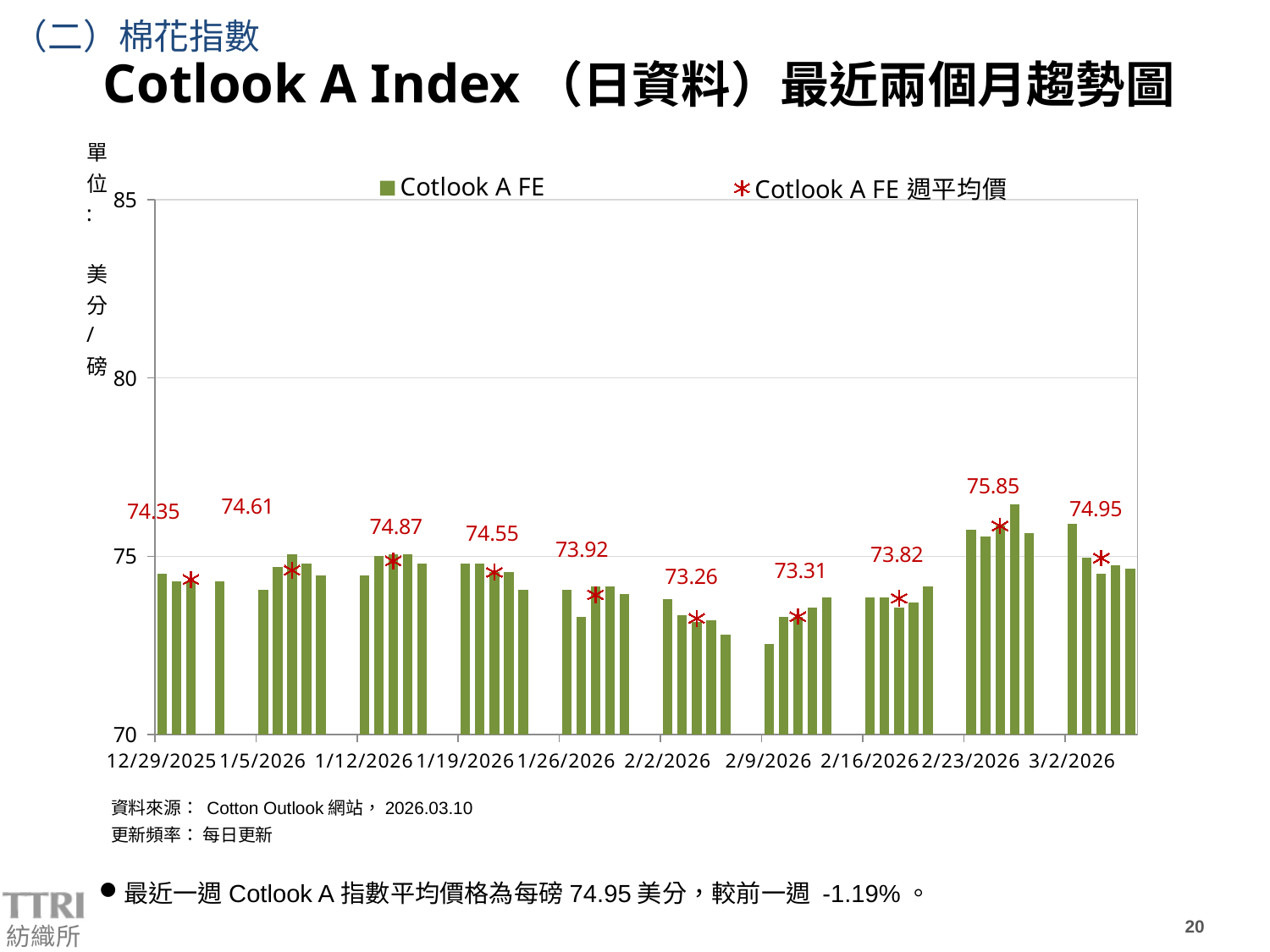
What kind of chart is used to show the daily Cotlook A FE values? bar chart What is the Cotlook A FE weekly average price labelled for the week of 12/29/2025? 74.35 What is the Cotlook A FE weekly average price labelled for the week of 3/2/2026? 74.95 What is the difference between the weekly average prices labelled for the weeks of 2/23/2026 and 3/2/2026? 0.90 Is the tallest daily bar in the week of 2/23/2026 greater or less than 75? greater Which week has the lowest labelled Cotlook A FE weekly average price? 2/2/2026 How many series does the legend list? 2 Which week has the highest labelled Cotlook A FE weekly average price? 2/23/2026 Does the weekly average price rise or fall from the week of 2/23/2026 to the week of 3/2/2026? fall What is the Cotlook A FE weekly average price labelled for the week of 2/23/2026? 75.85 How many weekly average price labels are shown on the chart? 10 Which is larger, the weekly average price for the week of 1/12/2026 or the week of 1/19/2026? 1/12/2026